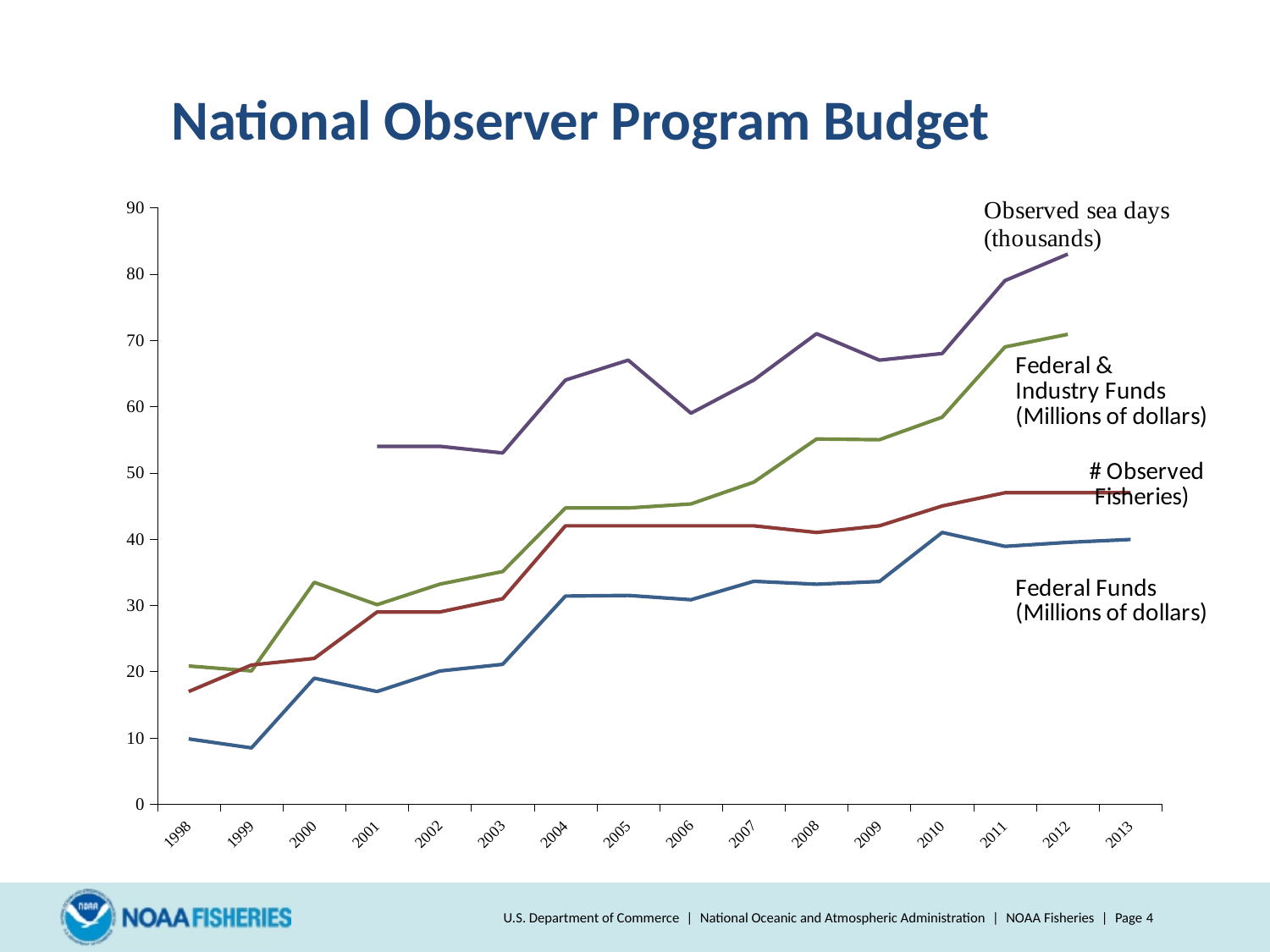
Overall, do Federal Funds (Millions of dollars) rise or fall from 1998 to 2013? rise How many years are shown along the x axis of the chart? 16 In which year does the Observed sea days (thousands) series reach its highest value? 2012 Is the value for Federal Funds (Millions of dollars) in 1999 greater or less than 10? less How many data series are plotted on the chart? 4 Which series is drawn in purple on the chart? Observed sea days (thousands) Is the value for Observed sea days (thousands) in 2012 greater or less than 80? greater Is the value for Federal Funds (Millions of dollars) in 2001 greater or less than 20? less In 2008, which is larger: Federal & Industry Funds (Millions of dollars) or # Observed Fisheries? Federal & Industry Funds (Millions of dollars) What is the title of the chart on the slide? National Observer Program Budget What kind of chart is shown on the slide? line chart